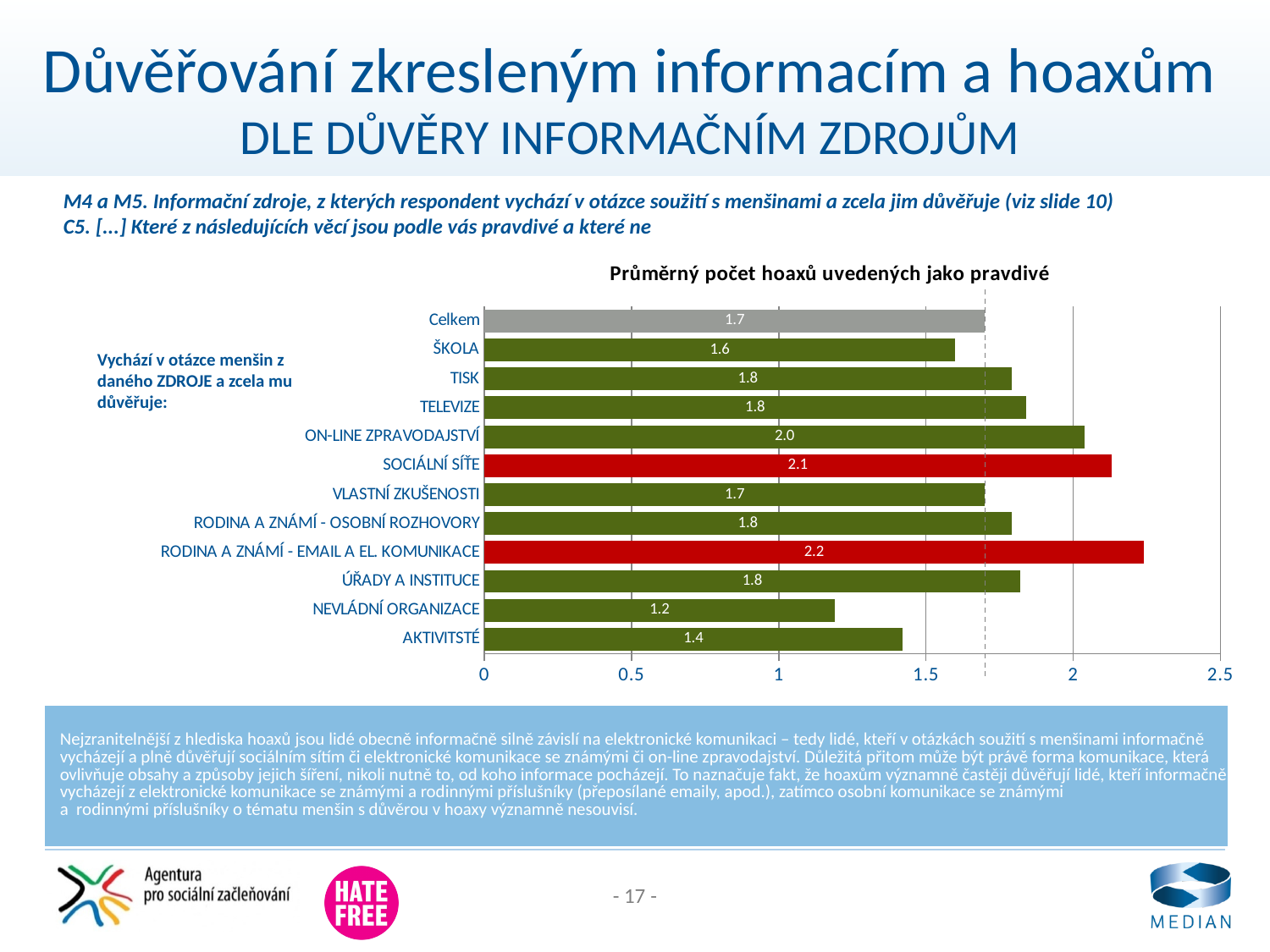
How many bars in the chart are coloured red? 2 Is the value for AKTIVITSTÉ greater or less than 1.5? less Which category has the lowest value? NEVLÁDNÍ ORGANIZACE What is the difference between the values for RODINA A ZNÁMÍ - EMAIL A EL. KOMUNIKACE and NEVLÁDNÍ ORGANIZACE? 1.0 How many categories (bars) are shown in the chart? 12 What is the value for NEVLÁDNÍ ORGANIZACE? 1.2 What is the value for SOCIÁLNÍ SÍTĚ? 2.1 Which has a larger value, SOCIÁLNÍ SÍTĚ or ŠKOLA? SOCIÁLNÍ SÍTĚ Which category has the highest value? RODINA A ZNÁMÍ - EMAIL A EL. KOMUNIKACE What kind of chart is shown on the slide? bar chart What is the title of the chart? Průměrný počet hoaxů uvedených jako pravdivé What is the value for the Celkem bar? 1.7